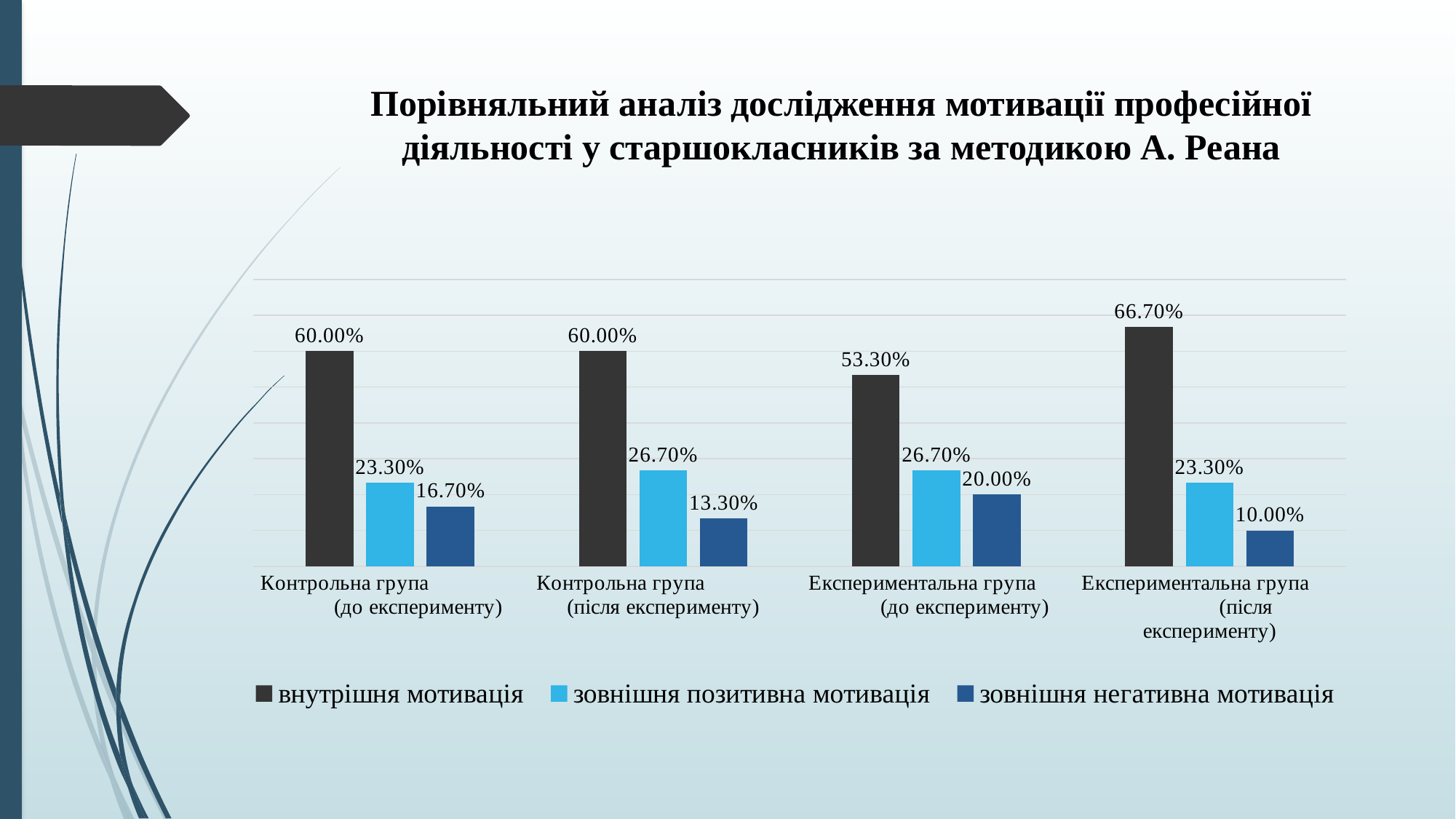
Which is larger: зовнішня негативна мотивація for Експериментальна група (до експерименту) or for Контрольна група (до експерименту)? Експериментальна група (до експерименту) What kind of chart is shown on the slide? Bar chart Which group has the lowest value for зовнішня негативна мотивація? Експериментальна група (після експерименту) What is the value of зовнішня позитивна мотивація for Експериментальна група (до експерименту)? 26.70% What is the value of внутрішня мотивація for Експериментальна група (після експерименту)? 66.70% How many groups (categories) are shown on the x axis? 4 What is the value of зовнішня негативна мотивація for Контрольна група (після експерименту)? 13.30% What is the total of the three motivation values for Контрольна група (до експерименту)? 100.00% What is the difference between внутрішня мотивація for Експериментальна група (після експерименту) and Експериментальна група (до експерименту)? 13.40% Which colour represents зовнішня позитивна мотивація in the legend? Light blue How many series does the legend list? 3 Which group has the highest value for внутрішня мотивація? Експериментальна група (після експерименту)